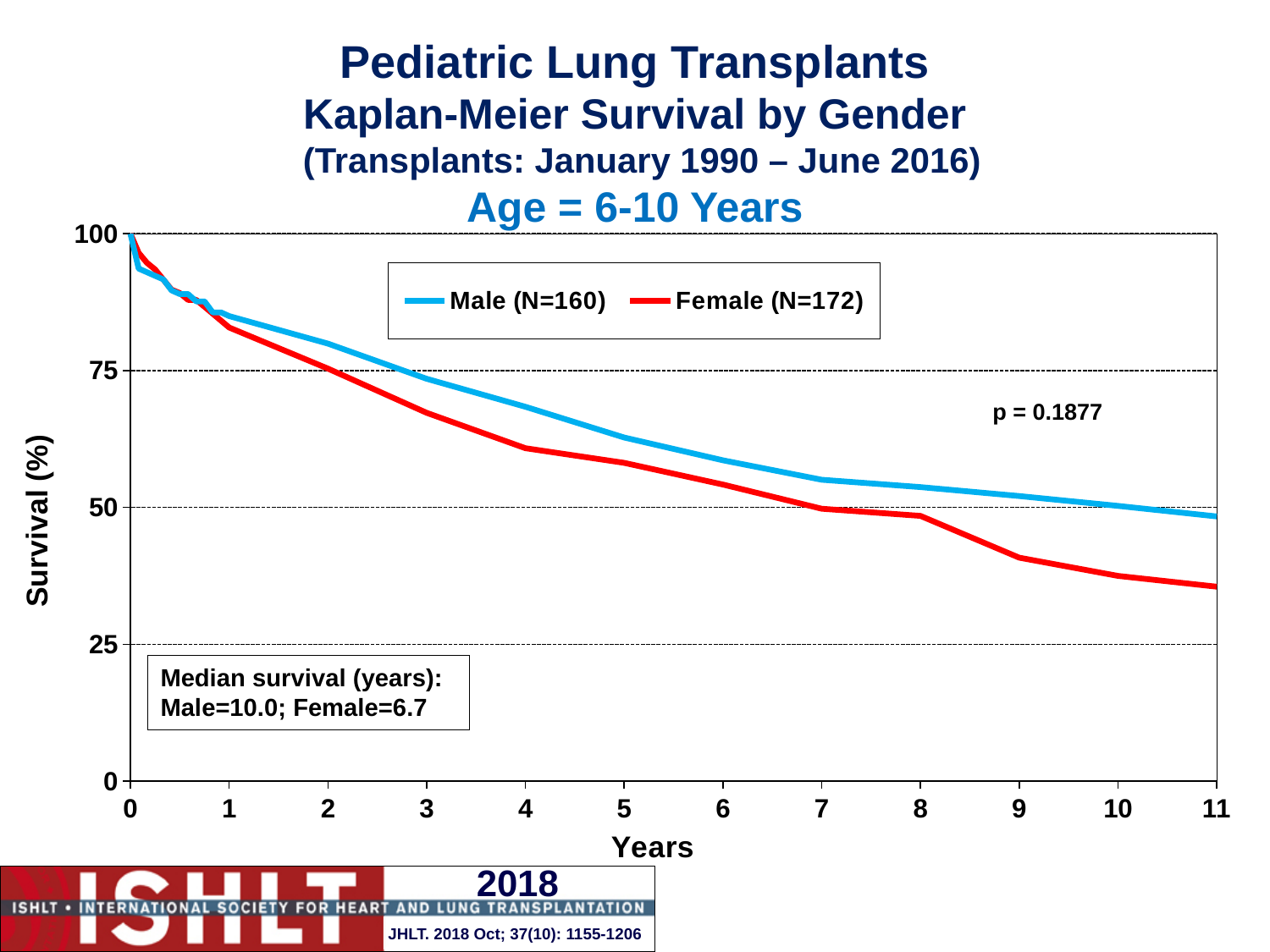
What kind of chart is shown on the slide? line chart What is the p-value printed on the chart? p = 0.1877 At year 9, which series has the higher survival, Male or Female? Male What is the median survival in years for females according to the text box on the chart? 6.7 Do the survival curves rise or fall as the years increase? fall What is the median survival in years for males according to the text box on the chart? 10.0 How many series does the legend list? 2 Is the Female survival value at year 10 greater or less than 50? less Is the Female survival value at year 3 greater or less than 75? less Is the Male survival value at year 5 greater or less than 50? greater What are the two series named in the legend? Male (N=160) and Female (N=172) What is the survival percentage for both series at year 0? 100